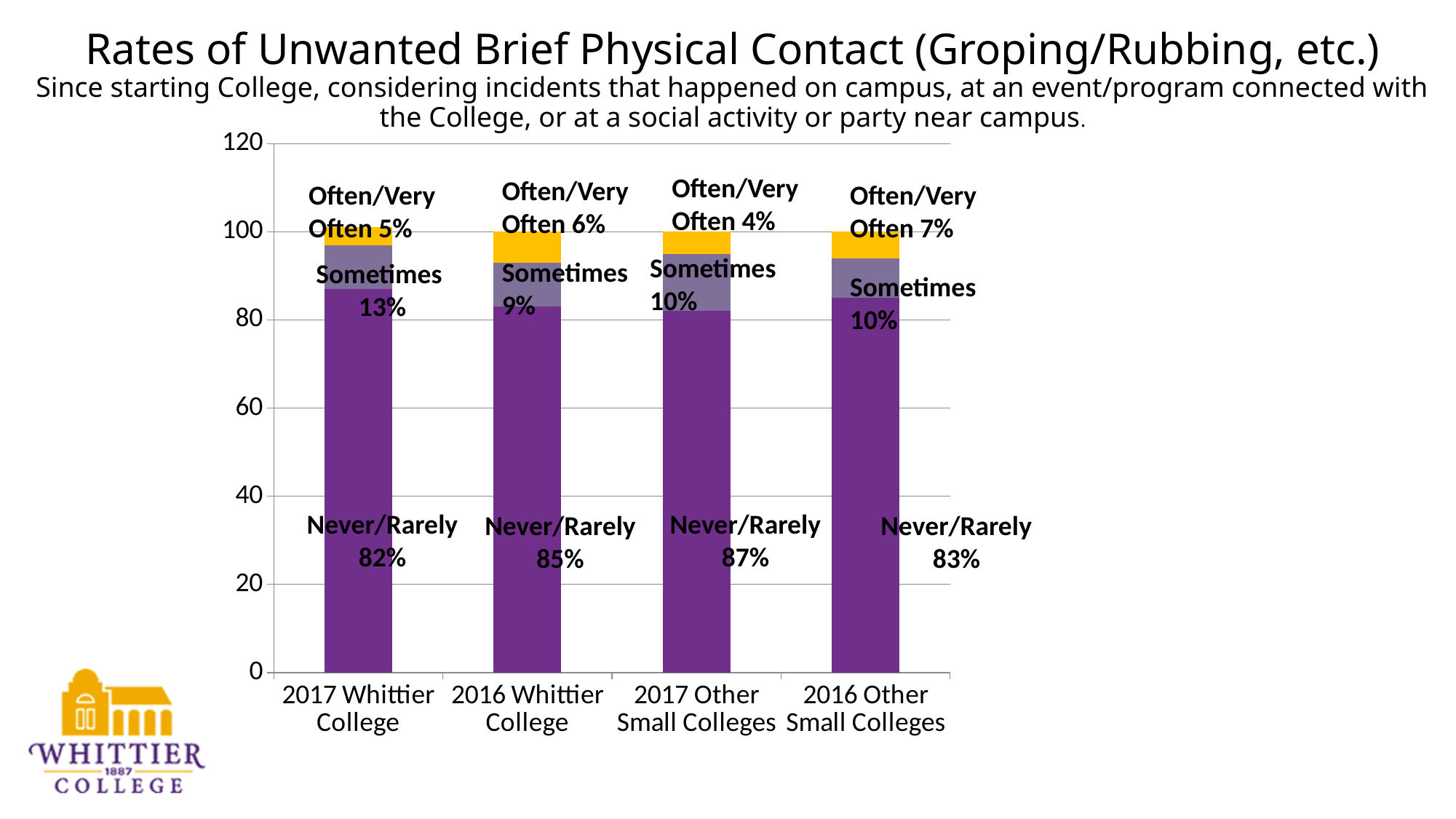
What is the Never/Rarely value for 2017 Whittier College? 82% What kind of chart is shown on the slide? Stacked bar chart What is the Sometimes value for 2016 Whittier College? 9% What is the Often/Very Often value for 2016 Other Small Colleges? 7% What is the total of the stacked bar for 2017 Whittier College? 100% What is the Often/Very Often value for 2017 Other Small Colleges? 4% Which is larger, the Sometimes value for 2017 Whittier College or for 2016 Whittier College? 2017 Whittier College Which category has the highest Sometimes value? 2017 Whittier College Which category has the lowest Often/Very Often value? 2017 Other Small Colleges What is the difference between the Never/Rarely values for 2017 Other Small Colleges and 2017 Whittier College? 5% Which category has the highest Never/Rarely value? 2017 Other Small Colleges How many categories are shown on the x axis? 4